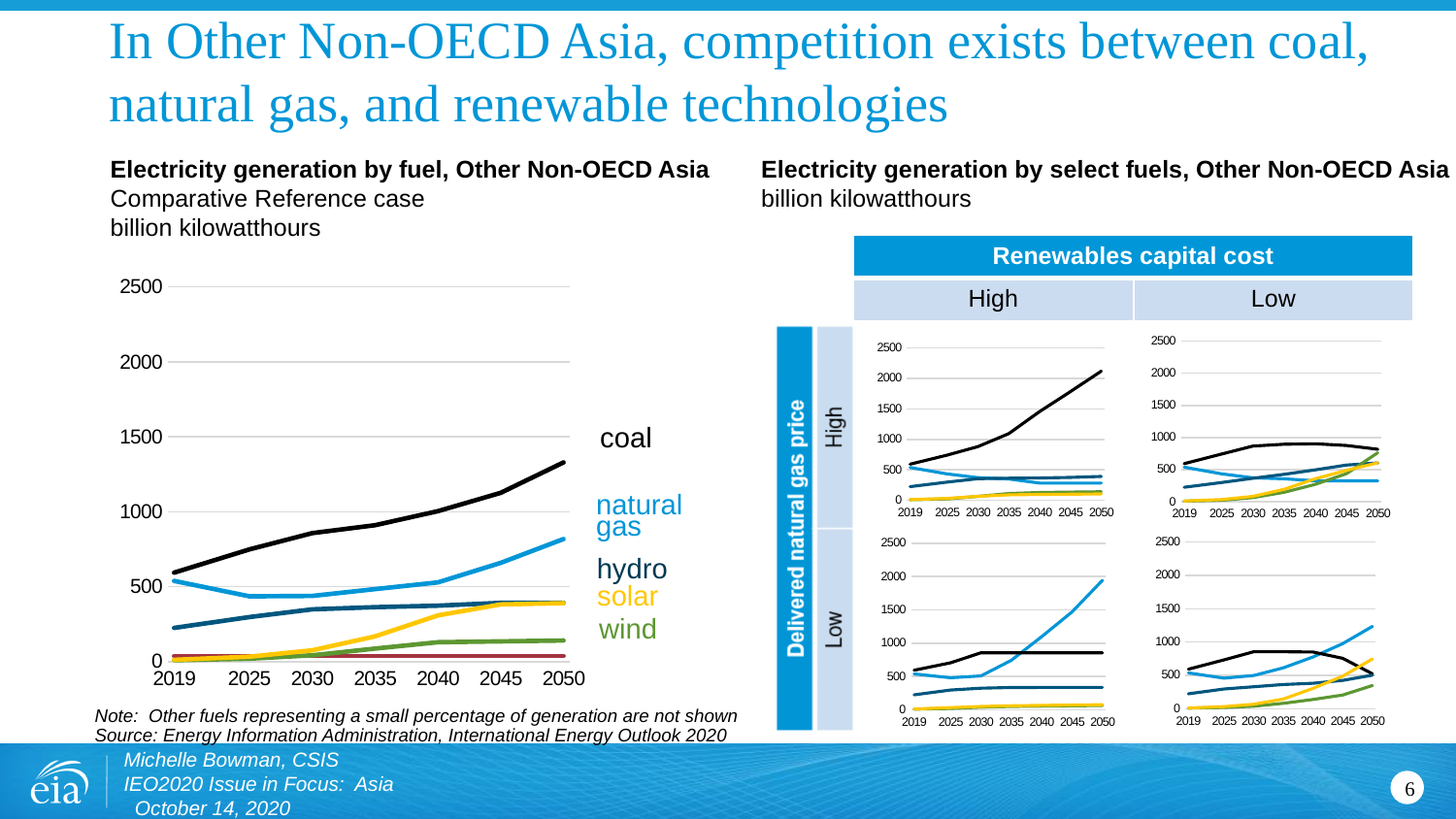
On the left chart, 'Electricity generation by fuel, Other Non-OECD Asia', which is larger in 2050: natural gas or hydro? natural gas On the right chart, 'Electricity generation by select fuels, Other Non-OECD Asia', in the panel with high renewables capital cost and low delivered natural gas price, is the value for natural gas in 2050 greater or less than 1500? greater On the right chart, 'Electricity generation by select fuels, Other Non-OECD Asia', in the panel with low renewables capital cost and low delivered natural gas price, is the value for coal in 2050 greater or less than 1000? less What kind of chart is the left chart, 'Electricity generation by fuel, Other Non-OECD Asia'? line chart On the left chart, 'Electricity generation by fuel, Other Non-OECD Asia', how many fuel series are labelled? 5 On the left chart, 'Electricity generation by fuel, Other Non-OECD Asia', which fuel has the highest generation in 2050? coal On the left chart, 'Electricity generation by fuel, Other Non-OECD Asia', how many year labels are shown on the x axis? 7 What unit of measurement is stated for the left chart, 'Electricity generation by fuel, Other Non-OECD Asia'? billion kilowatthours On the left chart, 'Electricity generation by fuel, Other Non-OECD Asia', is the value for coal in 2050 greater or less than 1000? greater On the left chart, 'Electricity generation by fuel, Other Non-OECD Asia', does coal generation rise or fall from 2019 to 2050? rise